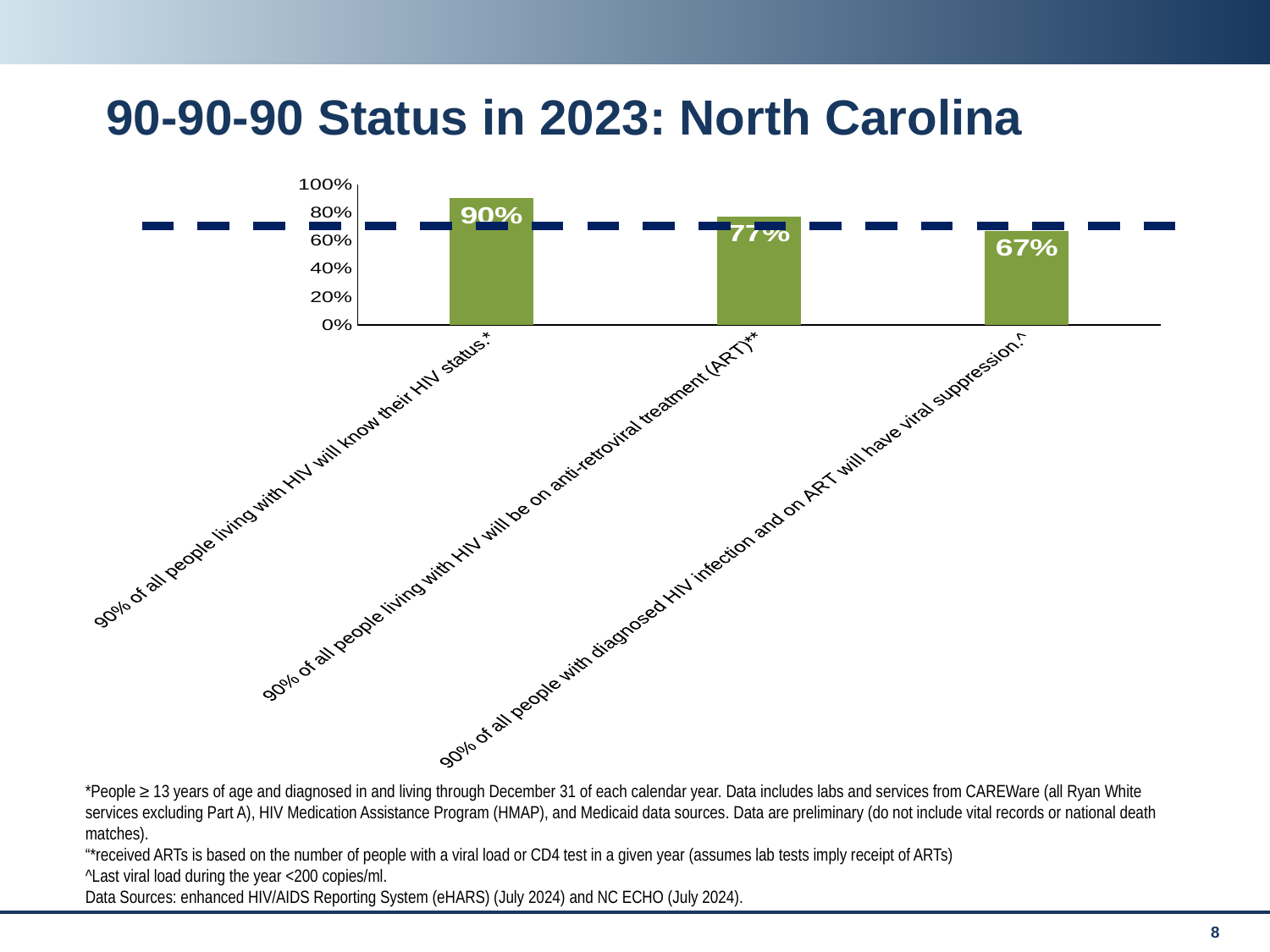
Which category has the highest value? 90% of all people living with HIV will know their HIV status What percentage of all people with diagnosed HIV infection and on ART have viral suppression? 67% Which category has the lowest value? 90% of all people with diagnosed HIV infection and on ART will have viral suppression How many bars are shown in the chart? 3 Do the values rise or fall from left to right across the categories? Fall What is the difference between the value for knowing HIV status and the value for being on ART? 13% What is the difference between the value for being on ART and the value for viral suppression? 10% What percentage of all people living with HIV know their HIV status? 90% Which is larger: the value for being on ART or the value for viral suppression? Being on ART (77%) Is the value for viral suppression greater or less than 80%? less What percentage of all people living with HIV are on anti-retroviral treatment (ART)? 77% What kind of chart is shown on the slide? Bar chart